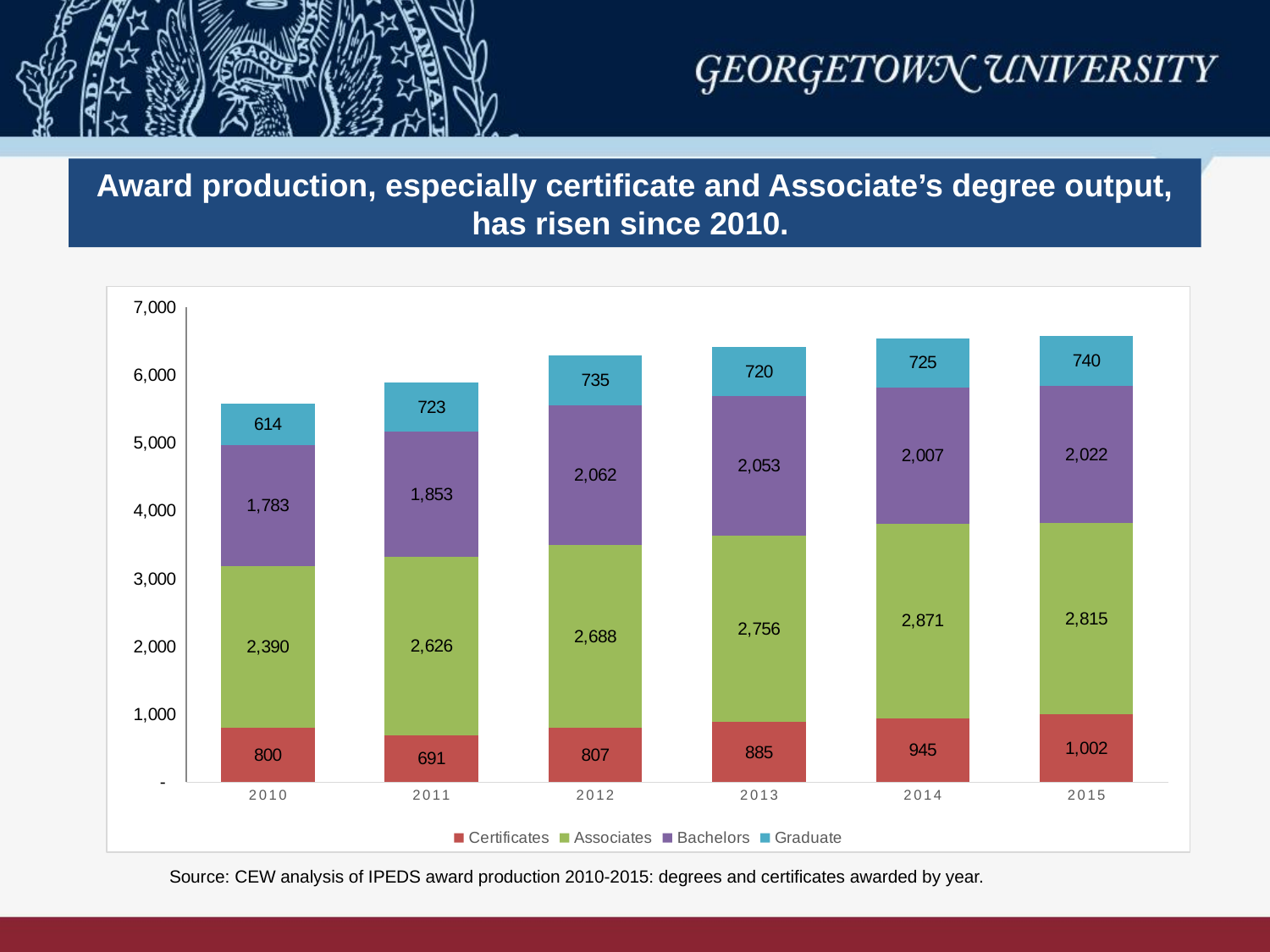
What is the value for Associates in 2013? 2,756 How many years are shown on the x axis? 6 What type of chart is shown on the slide? Stacked bar chart What is the total of the stacked bar for 2010? 5,587 In which year is the Associates value highest? 2014 What is the value for Graduate in 2010? 614 What is the value for Certificates in 2015? 1,002 How many series does the legend list? 4 What is the difference between the Bachelors values in 2012 and 2010? 279 In which year is the Certificates value lowest? 2011 Which is larger, the Associates value in 2014 or in 2015? 2014 Which series is shown in green in the legend? Associates